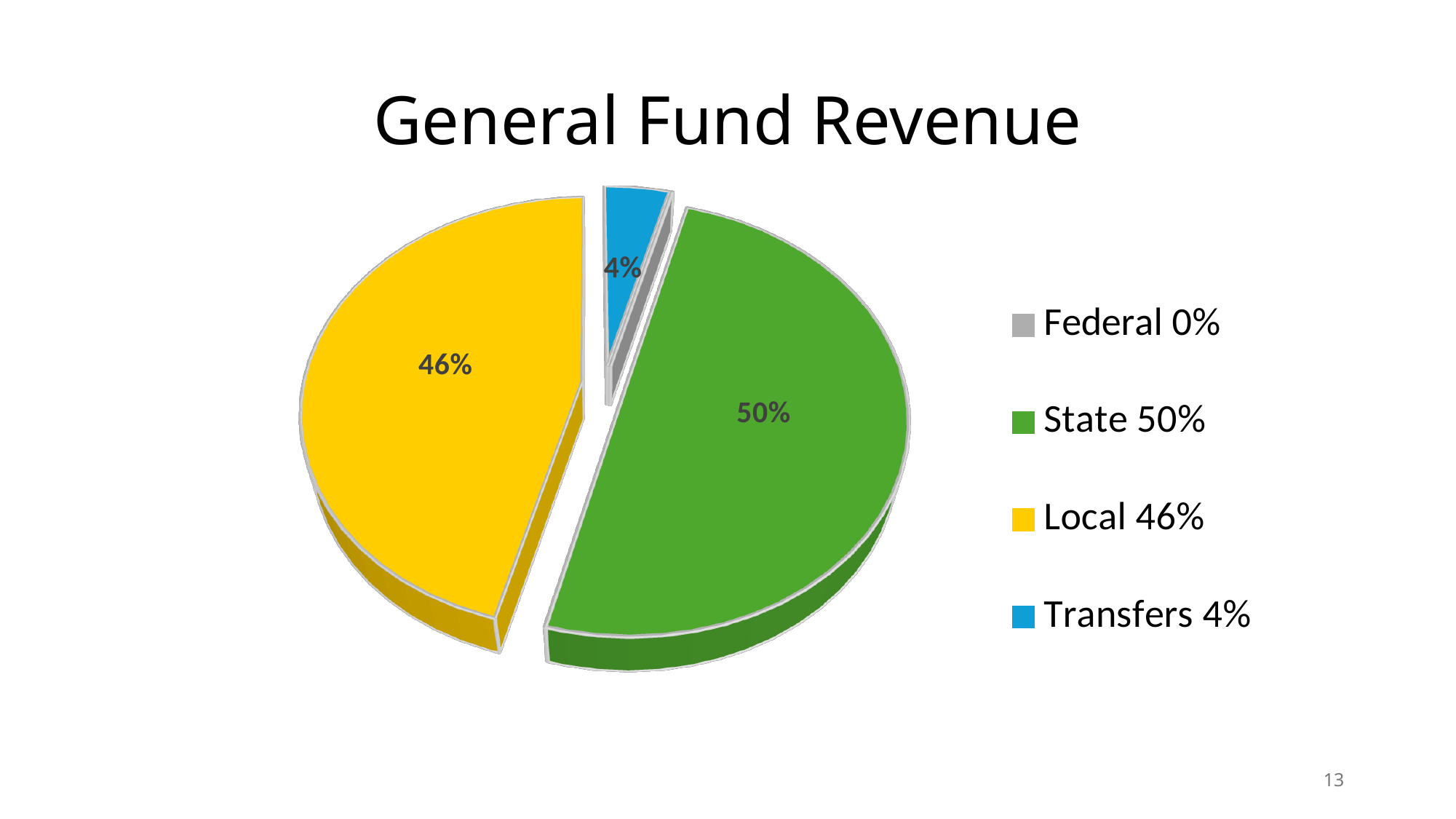
What share of General Fund Revenue comes from Federal? 0% What share of General Fund Revenue comes from Transfers? 4% What share of General Fund Revenue comes from Local? 46% How many categories does the legend list? 4 What colour is the Local slice? yellow Which is larger, the Local share or the Transfers share? Local What share of General Fund Revenue comes from State? 50% Which category has the largest share of General Fund Revenue? State Which category has the smallest share of General Fund Revenue? Federal What kind of chart is shown on the slide? pie chart What is the difference between the State share and the Local share? 4% What is the title of the chart? General Fund Revenue